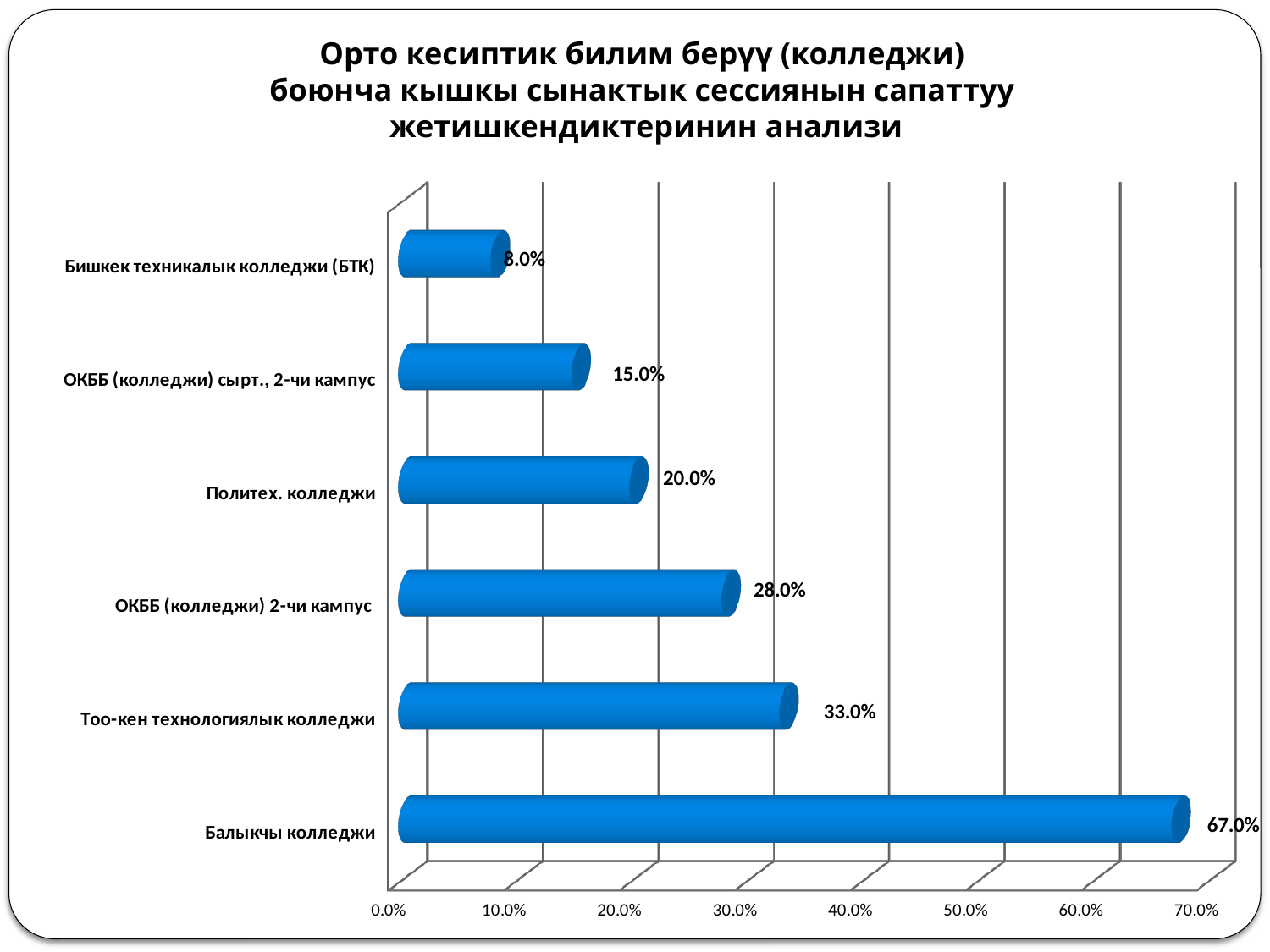
What is the value for Балыкчы колледжи? 67.0% What is the difference between the values for ОКББ (колледжи) 2-чи кампус and ОКББ (колледжи) сырт., 2-чи кампус? 13.0% Which is larger, the value for Политех. колледжи or the value for ОКББ (колледжи) сырт., 2-чи кампус? Политех. колледжи Which category has the highest value? Балыкчы колледжи What is the value for Бишкек техникалык колледжи (БТК)? 8.0% Which category has the lowest value? Бишкек техникалык колледжи (БТК) How many categories are shown in the chart? 6 What is the value for Политех. колледжи? 20.0% What is the value for Тоо-кен технологиялык колледжи? 33.0% What is the difference between the values for Балыкчы колледжи and Тоо-кен технологиялык колледжи? 34.0% What kind of chart is shown on the slide? Bar chart Is the value for ОКББ (колледжи) 2-чи кампус greater or less than 30.0%? less